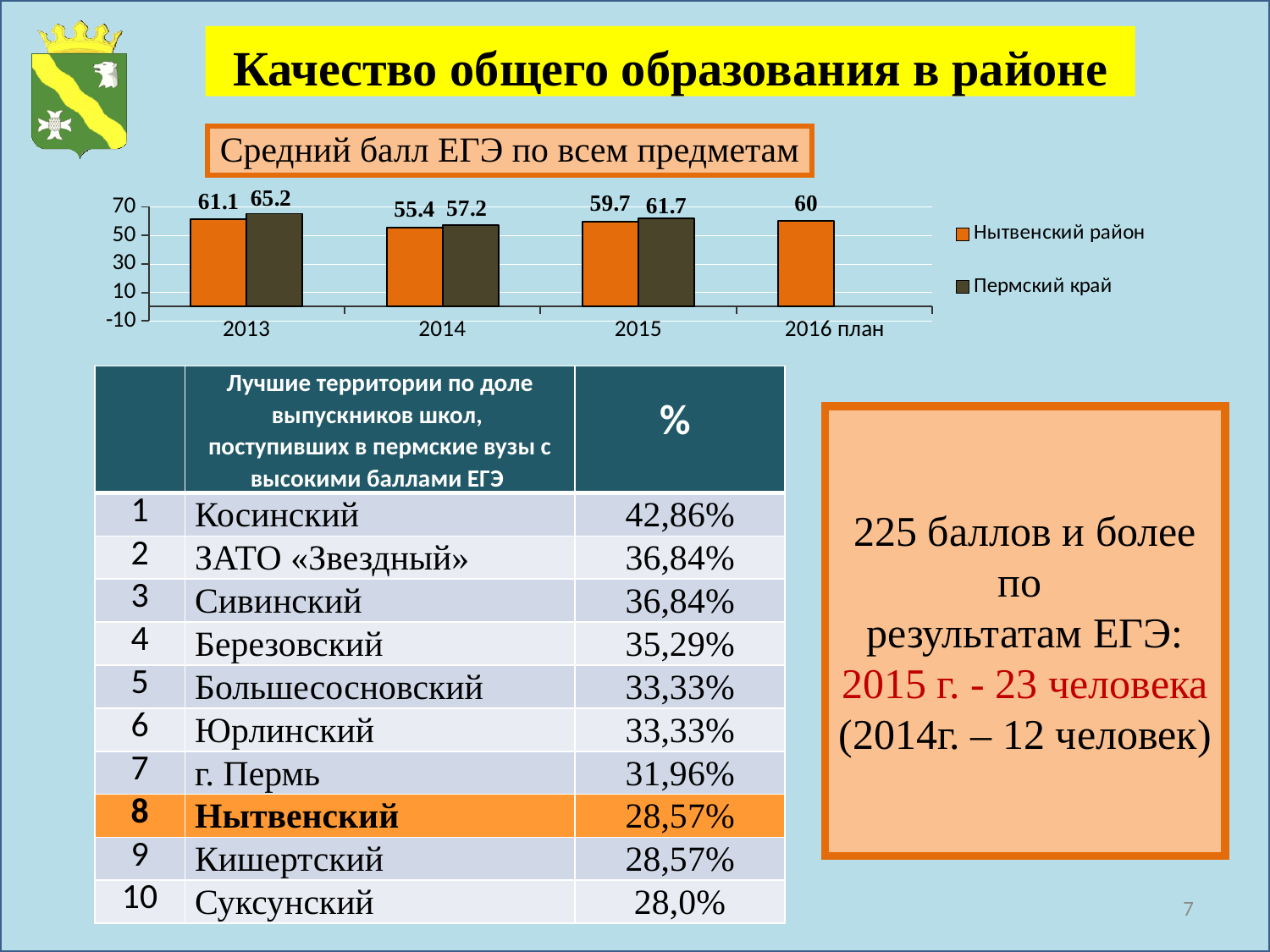
What is the value for Нытвенский район in 2016 план? 60 What is the difference between Пермский край and Нытвенский район in 2013? 4.1 How many categories are shown on the x axis? 4 Which is larger in 2015: Нытвенский район or Пермский край? Пермский край In which year is the value for Нытвенский район lowest? 2014 What is the value for Нытвенский район in 2013? 61.1 How many series does the legend list? 2 What kind of chart is shown on the slide? bar chart What is the value for Пермский край in 2015? 61.7 What is the value for Пермский край in 2014? 57.2 What is the title of the chart? Средний балл ЕГЭ по всем предметам In which year is the value for Пермский край highest? 2013